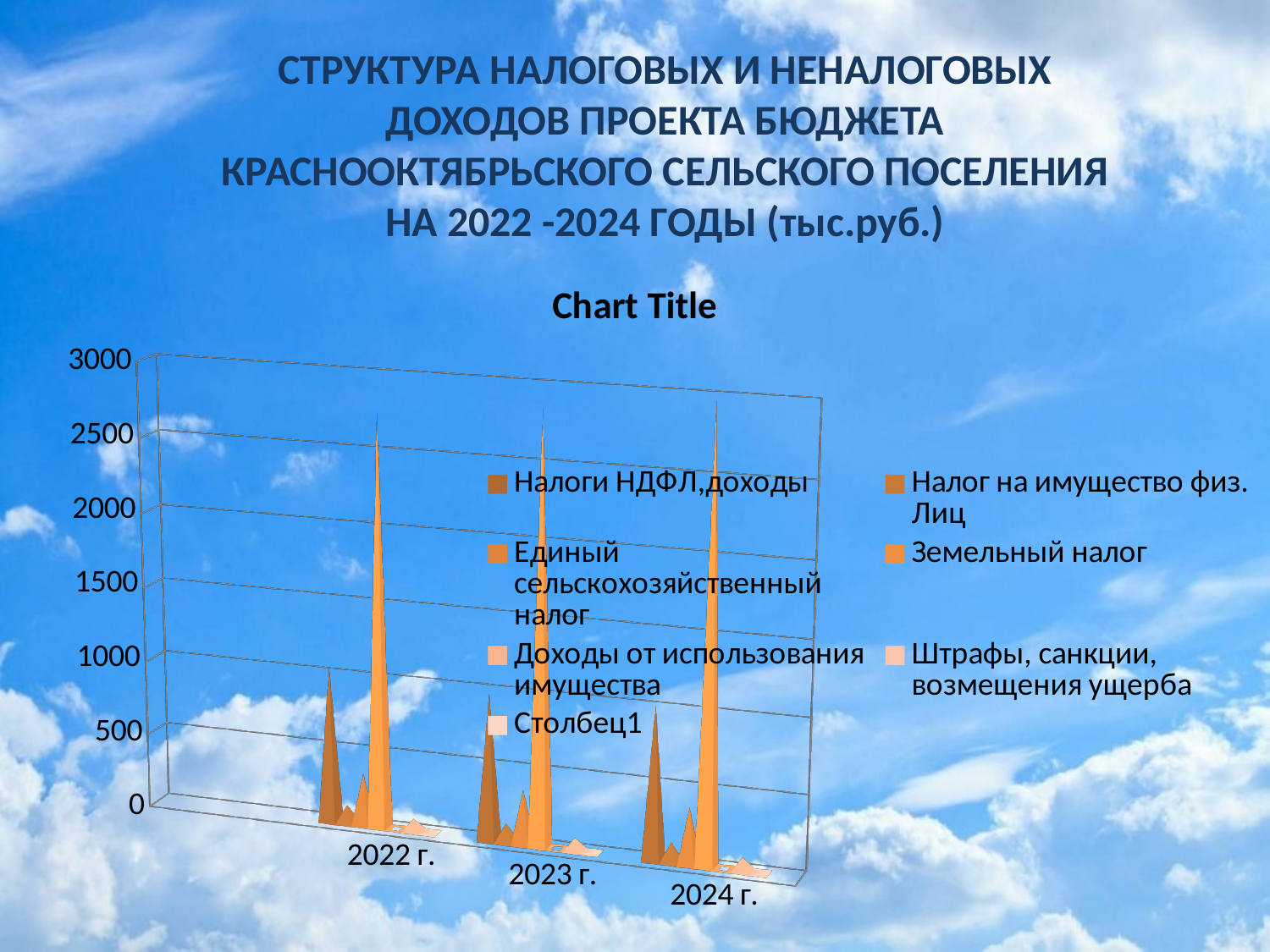
Which year category is listed first on the x axis? 2022 г. Which series has the highest value in 2024 г.? Земельный налог Is the value for Штрафы, санкции, возмещения ущерба in 2023 г. greater or less than 500? less Is the value for Налоги НДФЛ,доходы in 2022 г. greater or less than 1500? less How many year categories are shown on the x axis of the chart? 3 What is the title shown above the chart? Chart Title In 2022 г., which is larger: Земельный налог or Налоги НДФЛ,доходы? Земельный налог What is the highest value shown on the chart's vertical axis? 3000 How many series does the chart legend list? 7 Is the value for Земельный налог in 2024 г. greater or less than 1500? greater Which year category is listed last on the x axis? 2024 г.